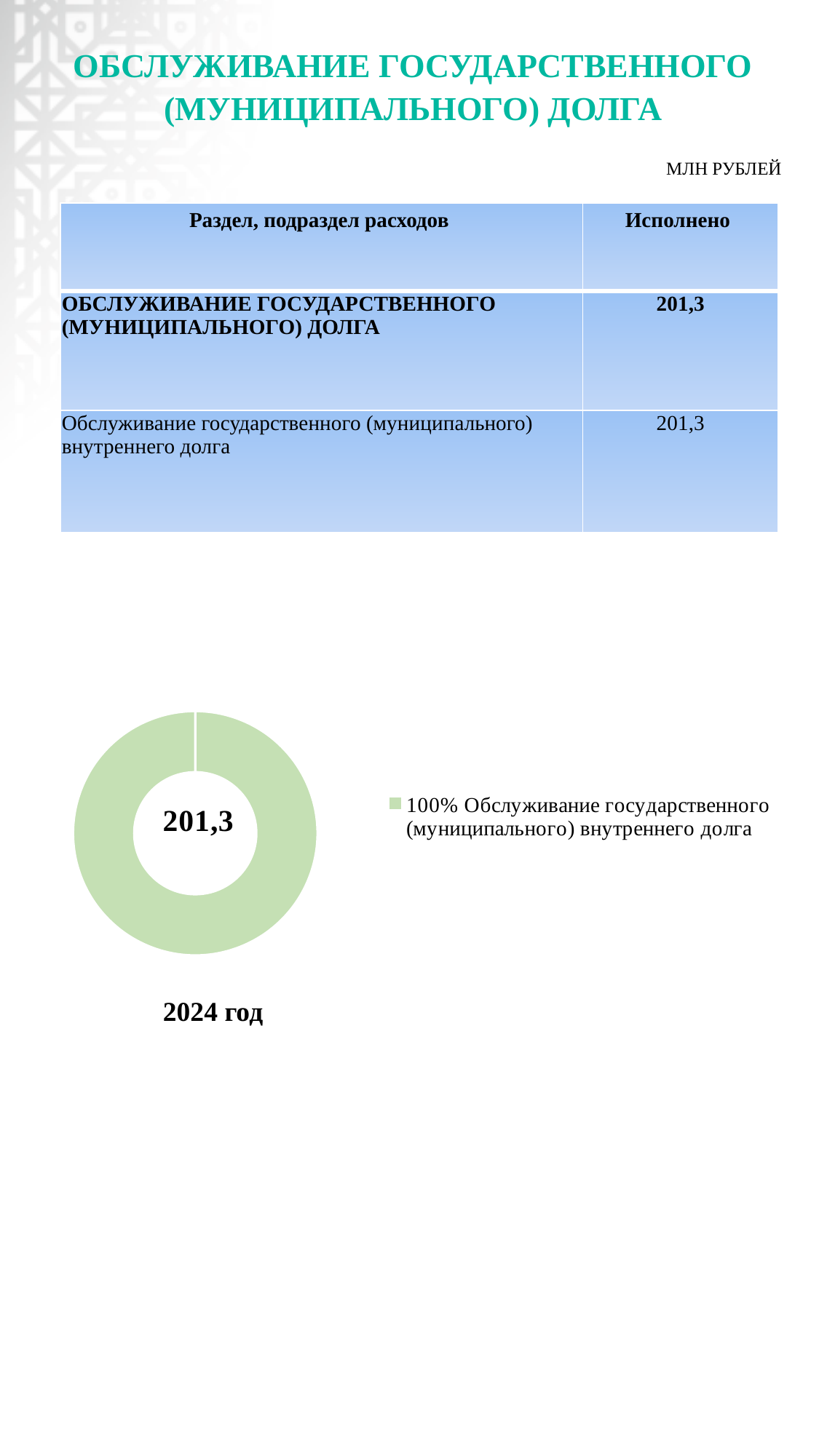
Is the value shown in the centre of the doughnut chart greater or less than 200? greater What is the legend entry of the doughnut chart? 100% Обслуживание государственного (муниципального) внутреннего долга What share of the doughnut chart does "Обслуживание государственного (муниципального) внутреннего долга" take? 100% What is the title shown under the doughnut chart? 2024 год What kind of chart is shown on the slide? doughnut chart How many slices does the doughnut chart have? 1 How many entries does the legend of the doughnut chart list? 1 What value is printed in the centre of the doughnut chart? 201,3